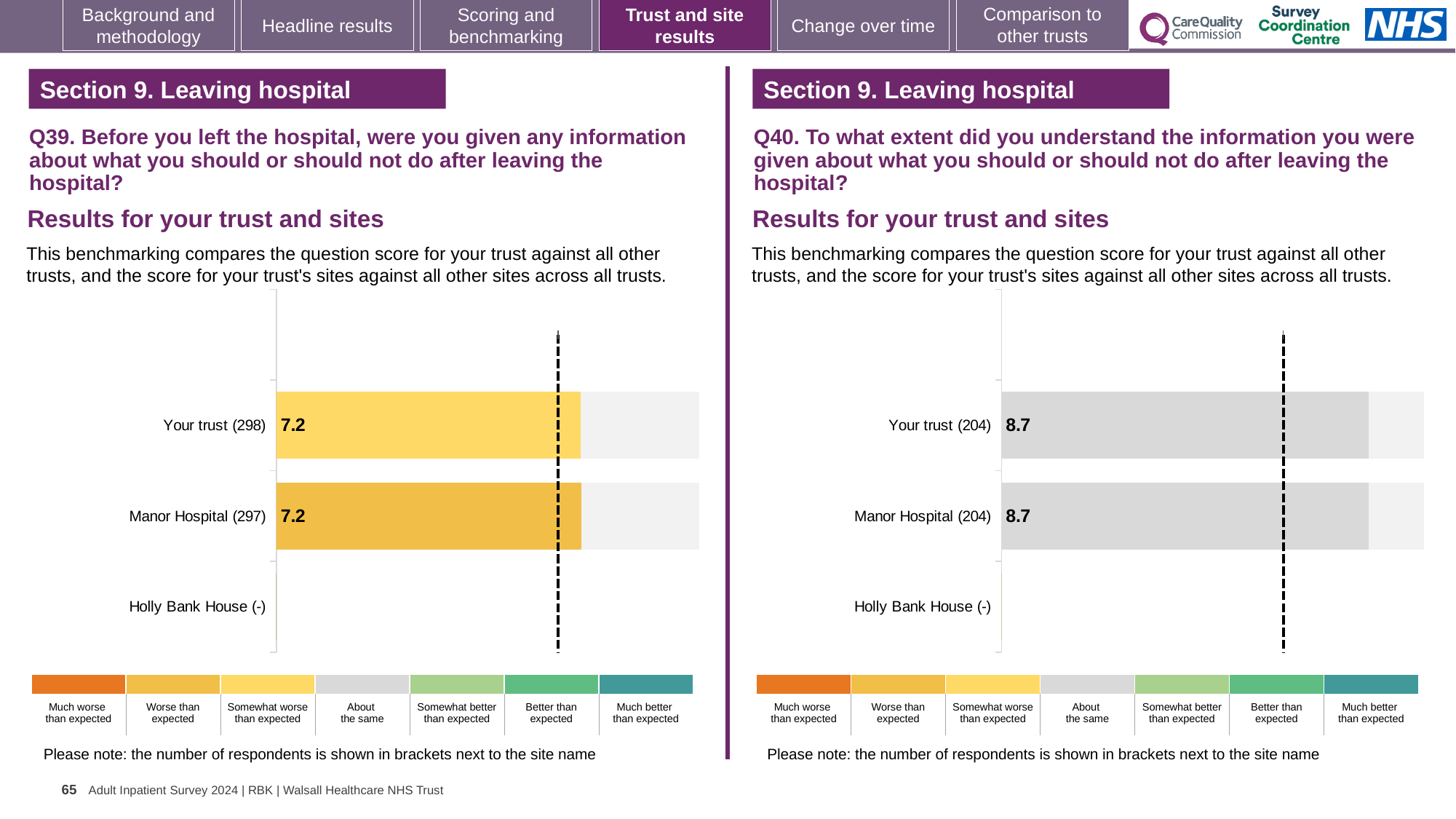
What kind of chart is used for the Q39 results on the left? Bar chart In the Q39 chart on the left, what is the score for Manor Hospital? 7.2 In the Q40 chart on the right, what is the difference between the scores for Your trust and Manor Hospital? 0.0 In the Q39 chart on the left, how many respondents are shown in brackets for Manor Hospital? 297 In the Q40 chart on the right, what is the score for Your trust? 8.7 How many site/trust categories are listed on the y axis of the Q40 chart on the right? 3 In the Q39 chart on the left, what is the score for Your trust? 7.2 In the Q40 chart on the right, how many respondents are shown in brackets for Your trust? 204 In the Q40 chart on the right, which benchmark category does the grey colour of the bars correspond to in the legend? About the same In the Q40 chart on the right, what is the score for Manor Hospital? 8.7 In the Q39 chart on the left, what is the difference between the scores for Your trust and Manor Hospital? 0.0 How many site/trust categories are listed on the y axis of the Q39 chart on the left? 3